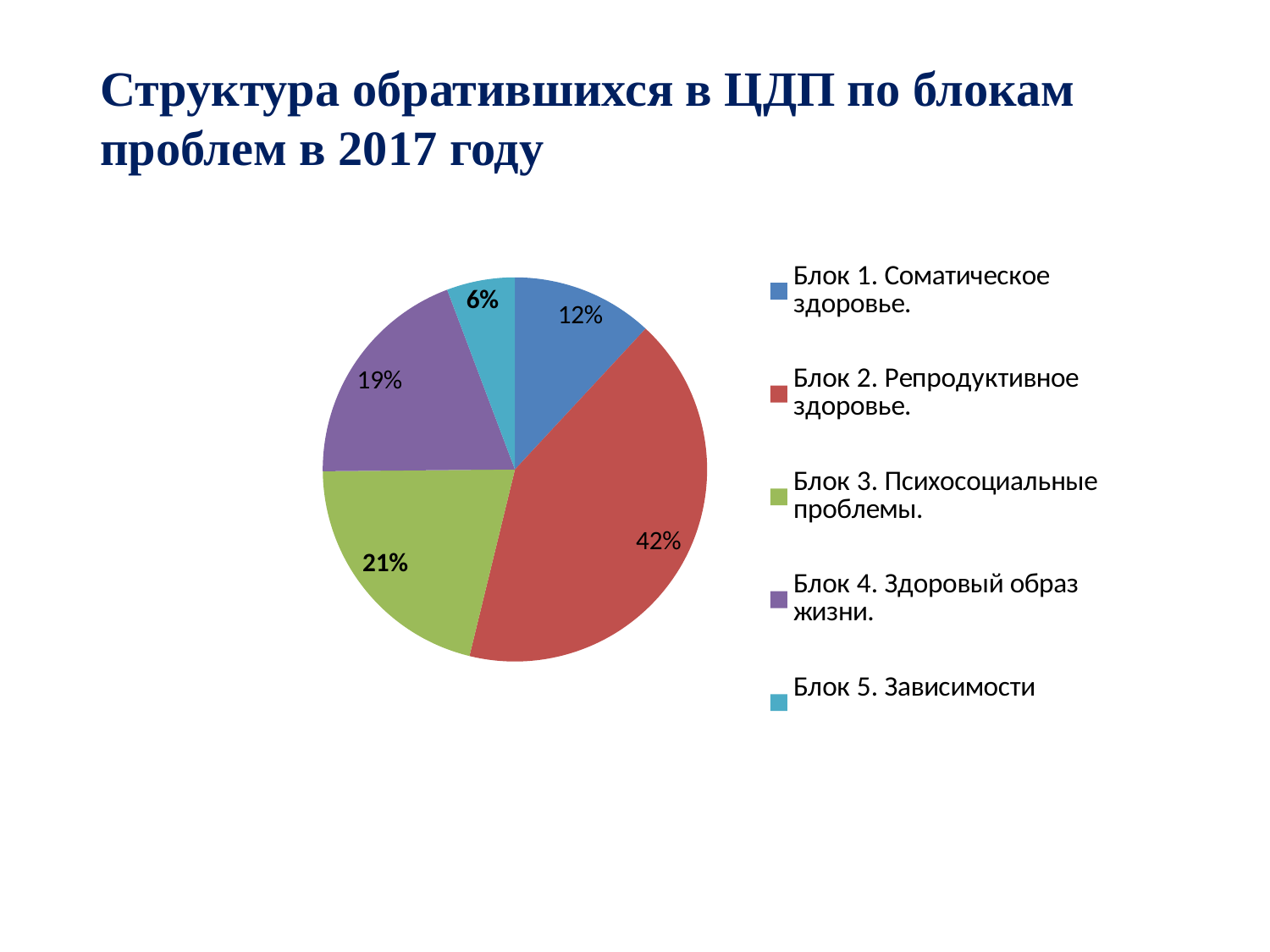
What share of the pie does "Блок 2. Репродуктивное здоровье." have? 42% What type of chart is shown on the slide? pie chart What is the value shown for "Блок 3. Психосоциальные проблемы."? 21% What is the difference between the shares of "Блок 2. Репродуктивное здоровье." and "Блок 3. Психосоциальные проблемы."? 21% Which is larger: the share for "Блок 4. Здоровый образ жизни." or for "Блок 1. Соматическое здоровье."? Блок 4. Здоровый образ жизни. What is the value shown for "Блок 4. Здоровый образ жизни."? 19% What colour is the slice for "Блок 5. Зависимости"? light blue (cyan) What is the value shown for "Блок 5. Зависимости"? 6% How many categories does the pie chart have? 5 Which category has the smallest slice of the pie? Блок 5. Зависимости Which category has the largest slice of the pie? Блок 2. Репродуктивное здоровье. What is the value shown for "Блок 1. Соматическое здоровье."? 12%